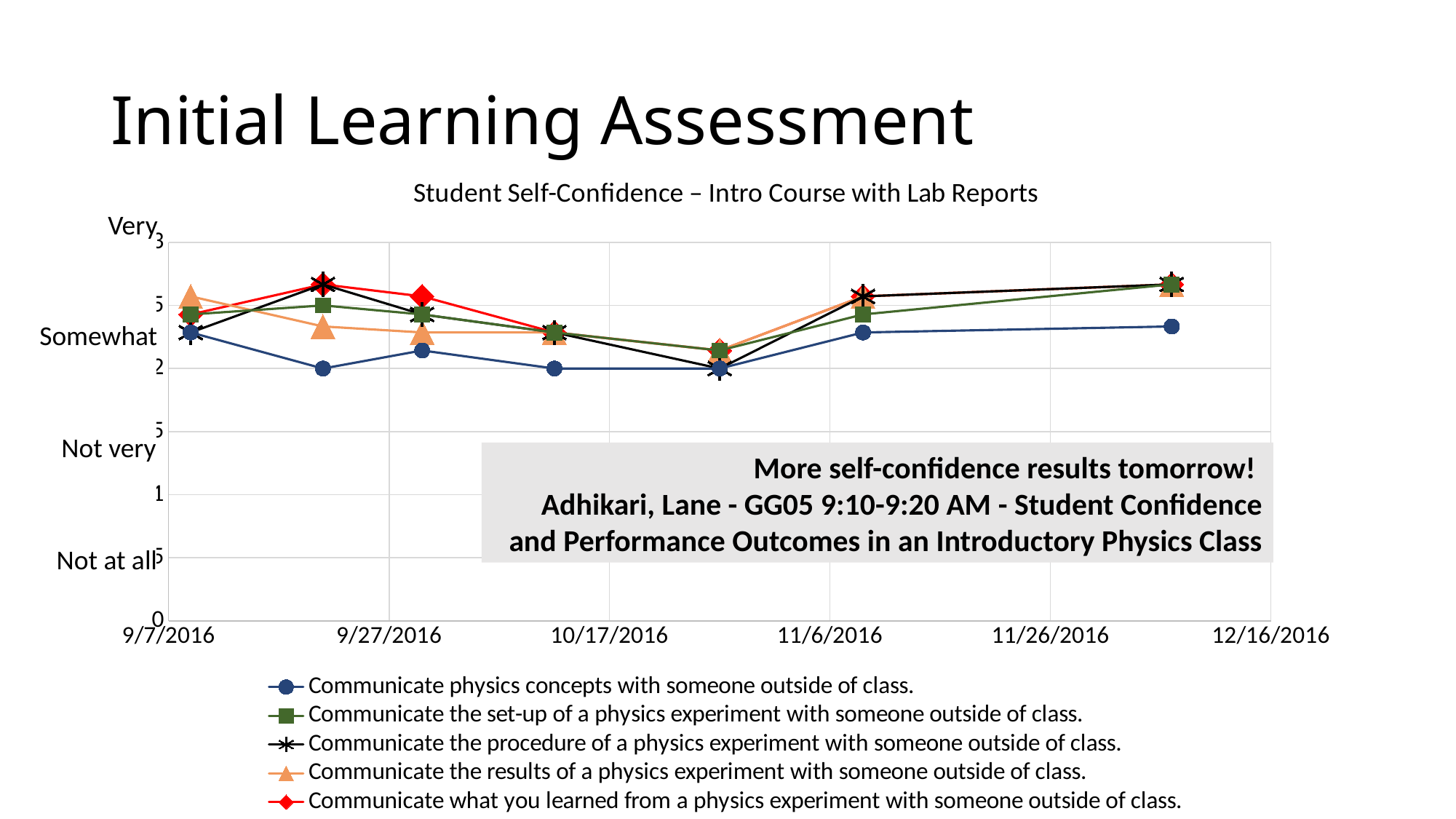
Which series has the lowest value at the final data point? Communicate physics concepts with someone outside of class. Which series is drawn with red diamond markers? Communicate what you learned from a physics experiment with someone outside of class. Is the final value for 'Communicate the set-up of a physics experiment with someone outside of class.' greater or less than 2.5? greater At the final data point, which is higher: 'Communicate physics concepts with someone outside of class.' or 'Communicate the set-up of a physics experiment with someone outside of class.'? Communicate the set-up of a physics experiment with someone outside of class. What type of chart is shown on the slide? line chart Is the value for 'Communicate the procedure of a physics experiment with someone outside of class.' at 9/7/2016 greater or less than 2.5? less From the late-October low point to the final data point, do the values for 'Communicate the set-up of a physics experiment with someone outside of class.' rise or fall? rise Is the final value for 'Communicate physics concepts with someone outside of class.' greater or less than 2.5? less How many series does the legend list? 5 What is the title of the chart? Student Self-Confidence – Intro Course with Lab Reports How many data points does each series have? 7